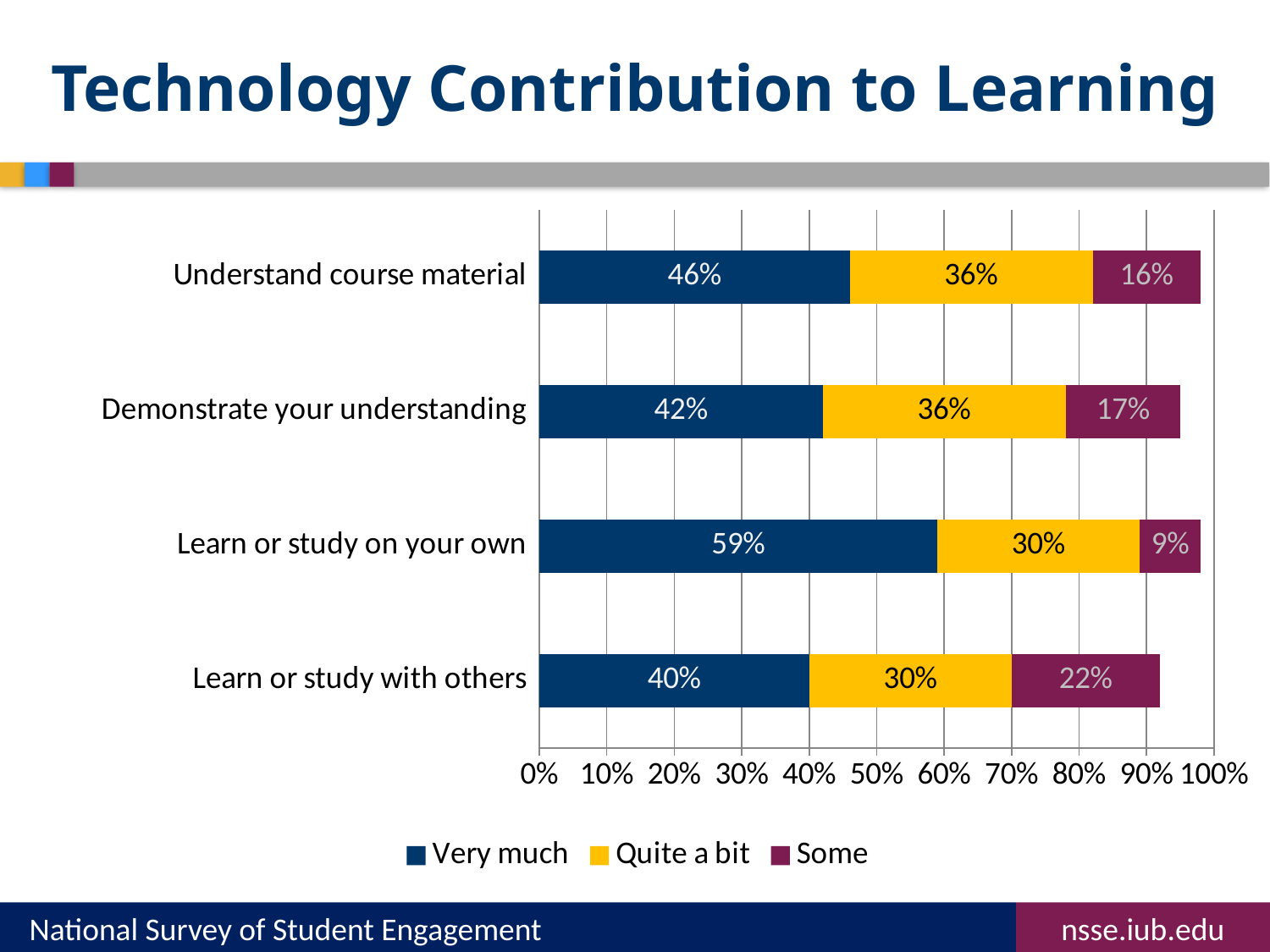
What kind of chart is shown on the slide? Stacked bar chart Which colour represents the "Quite a bit" series? Yellow What is the "Some" value for "Learn or study with others"? 22% What is the total of the three segments for "Learn or study on your own"? 98% How many series does the legend list? 3 How many categories are shown on the chart? 4 What is the "Quite a bit" value for "Demonstrate your understanding"? 36% Which category has the highest "Very much" value? Learn or study on your own What percentage of students said technology contributed "Very much" to learning or studying on their own? 59% Which category has the lowest "Some" value? Learn or study on your own What is the difference between the "Very much" values for "Understand course material" and "Learn or study with others"? 6% Which is larger: the "Some" value for "Demonstrate your understanding" or for "Understand course material"? Demonstrate your understanding